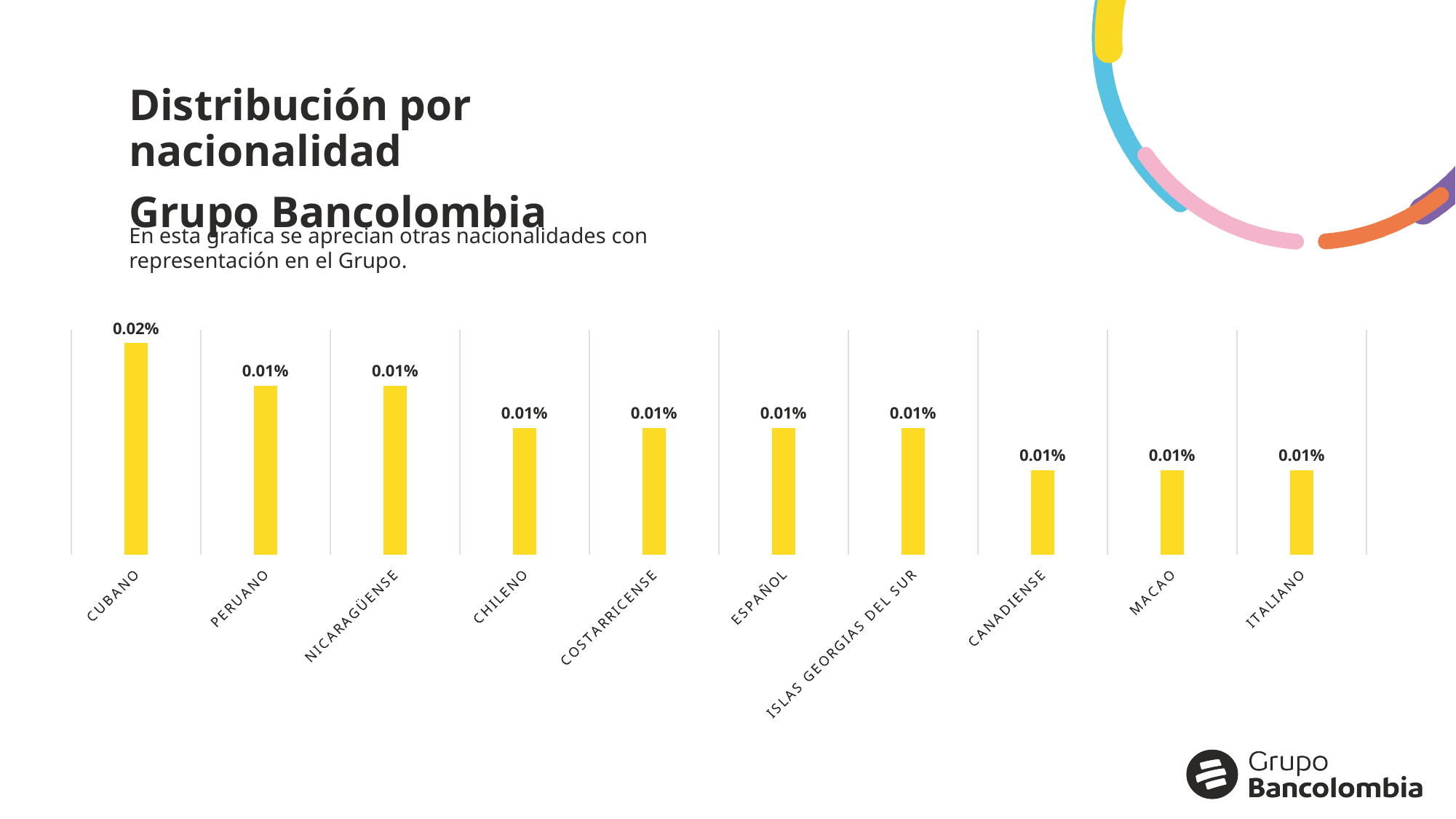
Which nationality has the highest value in the chart? CUBANO What is the value shown for ITALIANO? 0.01% What is the value shown for ISLAS GEORGIAS DEL SUR? 0.01% What is the value shown for CUBANO? 0.02% What is the value shown for CANADIENSE? 0.01% What is the difference between the values for CUBANO and PERUANO? 0.01% What is the value shown for PERUANO? 0.01% What is the title of the slide containing the chart? Distribución por nacionalidad Grupo Bancolombia Which has a larger value, CUBANO or CHILENO? CUBANO What kind of chart is shown on the slide? Bar chart How many nationalities are shown in the chart? 10 What colour are the bars in the chart? Yellow